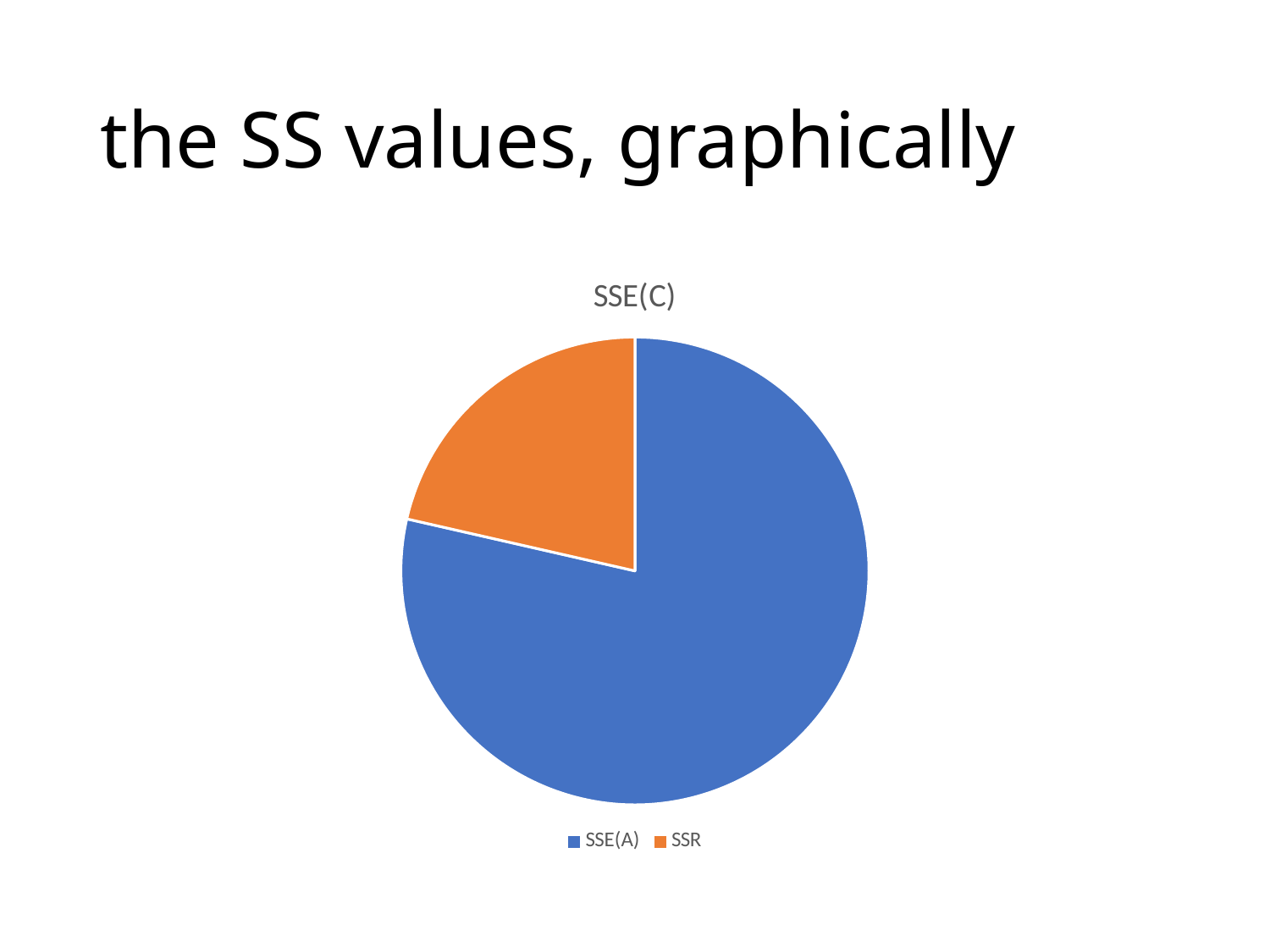
What colour is the SSR slice? orange Is the SSR slice more or less than half of the pie? less Is the SSE(A) slice more or less than half of the pie? more What kind of chart is shown on the slide? pie chart What is the title of the chart? SSE(C) Which slice is the largest in the pie chart? SSE(A) How many entries does the legend list? 2 Which slice is the smallest in the pie chart? SSR How many slices does the pie chart have? 2 Which is larger, the SSE(A) slice or the SSR slice? SSE(A)